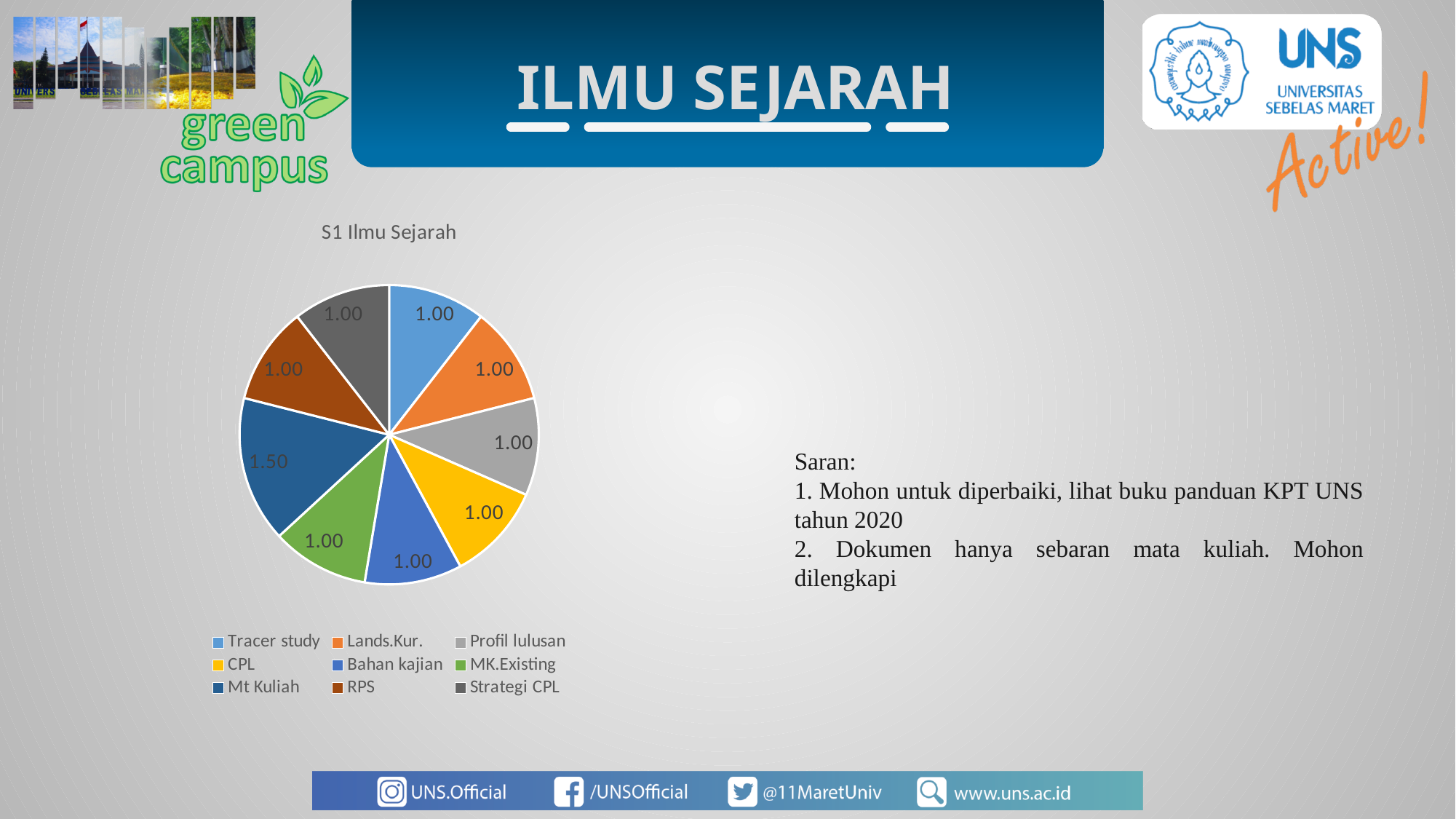
What share of the pie does the Mt Kuliah slice represent? 15.79% What is the value for RPS? 1.00 How many slices does the pie chart have? 9 Which is larger, the value for Mt Kuliah or the value for Bahan kajian? Mt Kuliah What is the value for Tracer study? 1.00 Which category has the largest slice in the pie chart? Mt Kuliah What is the difference between the values for Mt Kuliah and CPL? 0.50 What is the value for Mt Kuliah? 1.50 What is the total of all the slice values in the pie chart? 9.50 What is the title of the chart? S1 Ilmu Sejarah Which legend entry is shown in green? MK.Existing What type of chart is shown on the slide? pie chart